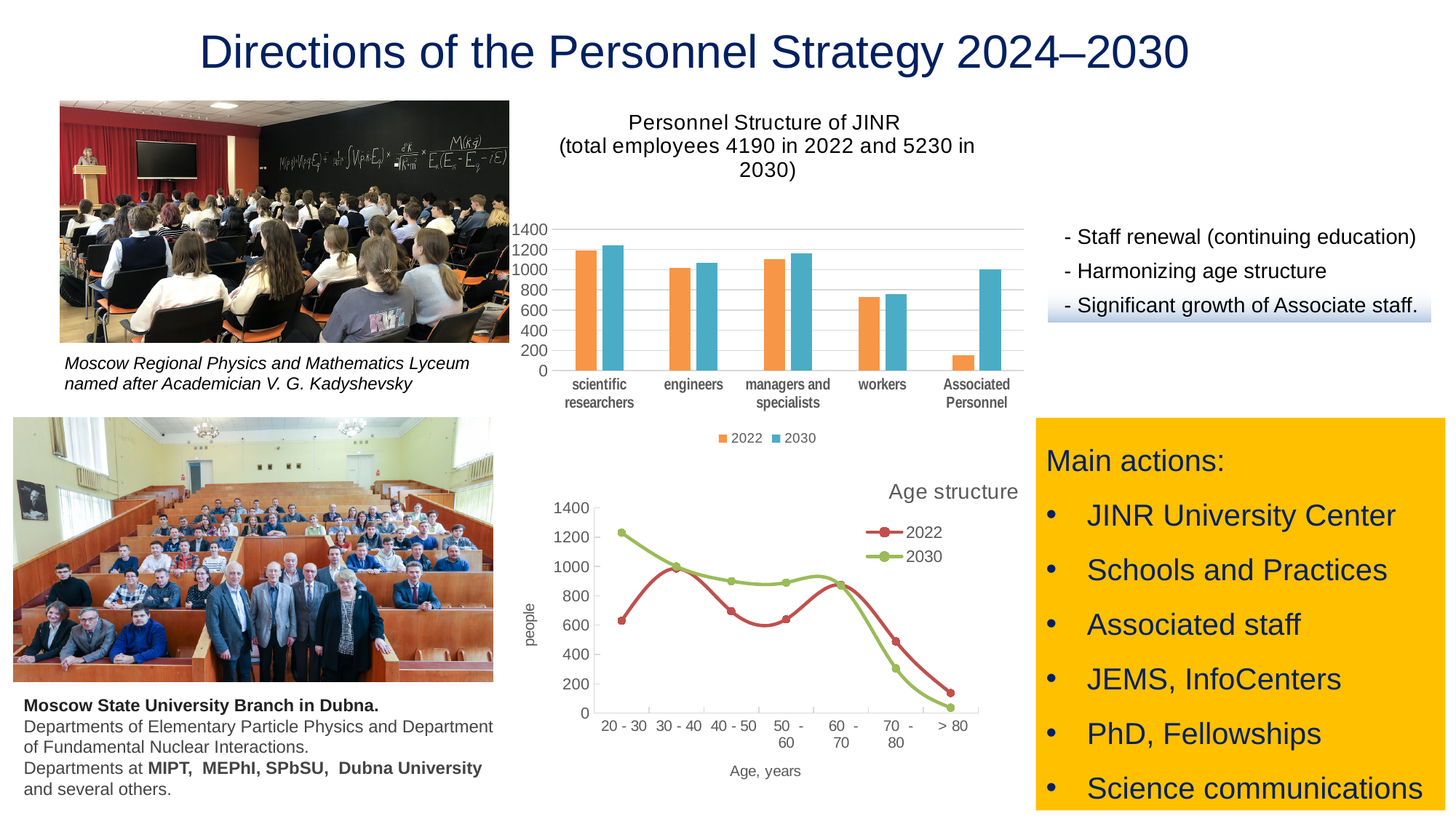
In the Personnel Structure of JINR chart, which is larger for Associated Personnel: the 2022 value or the 2030 value? 2030 What kind of chart is the Age structure chart? line chart What kind of chart is the Personnel Structure of JINR chart? bar chart In the Personnel Structure of JINR chart, is the 2030 value for workers greater or less than 800? less How many categories are shown on the x axis of the Personnel Structure of JINR chart? 5 How many age groups are plotted on the x axis of the Age structure chart? 7 In the Age structure chart, which age group has the highest value for 2030? 20 - 30 How many series does the legend of the Personnel Structure of JINR chart list? 2 In the Age structure chart, is the 2022 value for the > 80 age group greater or less than 200? less In the Personnel Structure of JINR chart, is the 2022 value for Associated Personnel greater or less than 200? less In the Personnel Structure of JINR chart, which category has the lowest value for 2022? Associated Personnel In the Age structure chart, does the 2030 line rise or fall overall from the 20 - 30 group to the > 80 group? fall